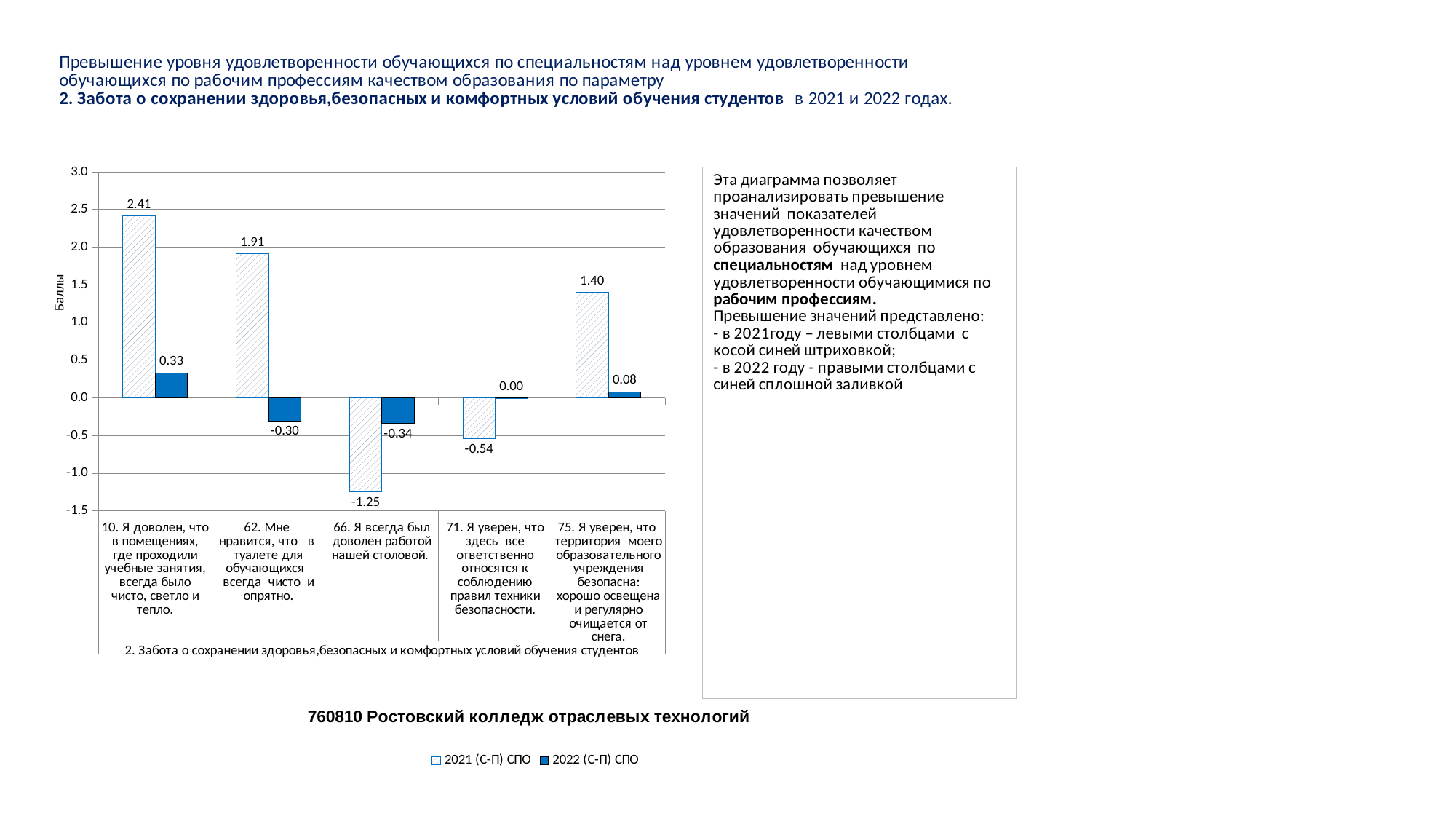
What is the value for 2022 (С-П) СПО for category 66 (Я всегда был доволен работой нашей столовой)? -0.34 What is the value for 2021 (С-П) СПО for category 75 (Я уверен, что территория моего образовательного учреждения безопасна)? 1.40 What is the difference between the 2021 (С-П) СПО and 2022 (С-П) СПО values for category 62 (Мне нравится, что в туалете для обучающихся всегда чисто и опрятно)? 2.21 Which category has the highest value for the 2021 (С-П) СПО series? 10. Я доволен, что в помещениях, где проходили учебные занятия, всегда было чисто, светло и тепло. What is the value for 2021 (С-П) СПО for category 10 (Я доволен, что в помещениях, где проходили учебные занятия, всегда было чисто, светло и тепло)? 2.41 Which is larger for category 75: the 2021 (С-П) СПО value or the 2022 (С-П) СПО value? 2021 (С-П) СПО Which category has the lowest value for the 2021 (С-П) СПО series? 66. Я всегда был доволен работой нашей столовой. What type of chart is shown on the slide? Bar chart What is the value for 2022 (С-П) СПО for category 71 (Я уверен, что здесь все ответственно относятся к соблюдению правил техники безопасности)? 0.00 What is the label of the vertical axis of the chart? Баллы How many series does the chart legend list? 2 How many categories are shown on the x axis of the chart? 5